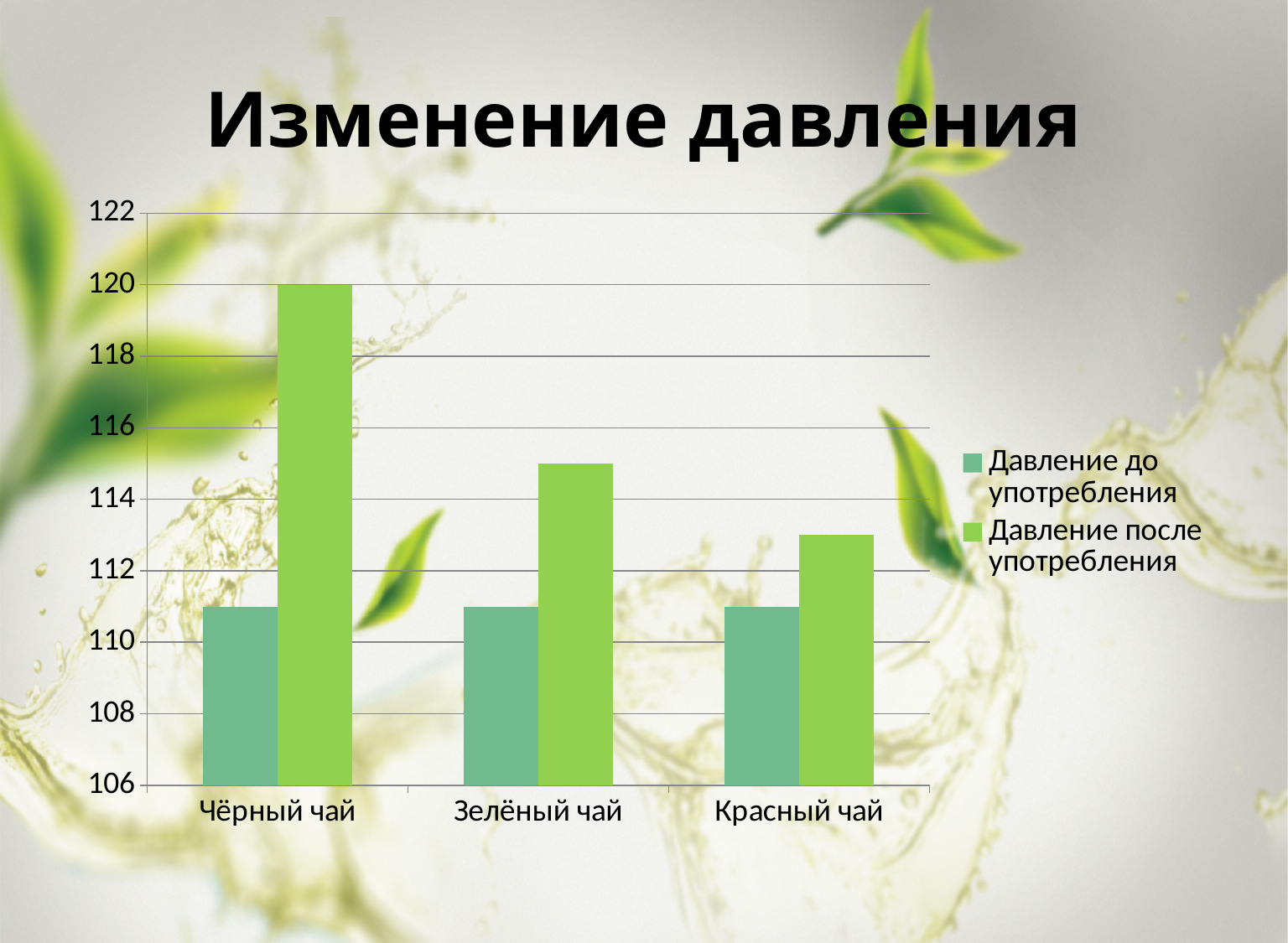
Which tea has the lowest 'Давление после употребления' value? Красный чай Is the 'Давление после употребления' value for Красный чай greater or less than 112? greater Is the 'Давление после употребления' value for Зелёный чай greater or less than 114? greater How many series does the legend list? 2 What kind of chart is shown on the slide? bar chart Which tea has the highest 'Давление после употребления' value? Чёрный чай Do the 'Давление после употребления' values rise or fall from Чёрный чай to Красный чай? fall What is the title of the chart? Изменение давления For Зелёный чай, which is larger: 'Давление до употребления' or 'Давление после употребления'? Давление после употребления What is the value of 'Давление после употребления' for Чёрный чай? 120 Is the 'Давление до употребления' value for Чёрный чай greater or less than 112? less How many tea categories are shown on the x axis? 3